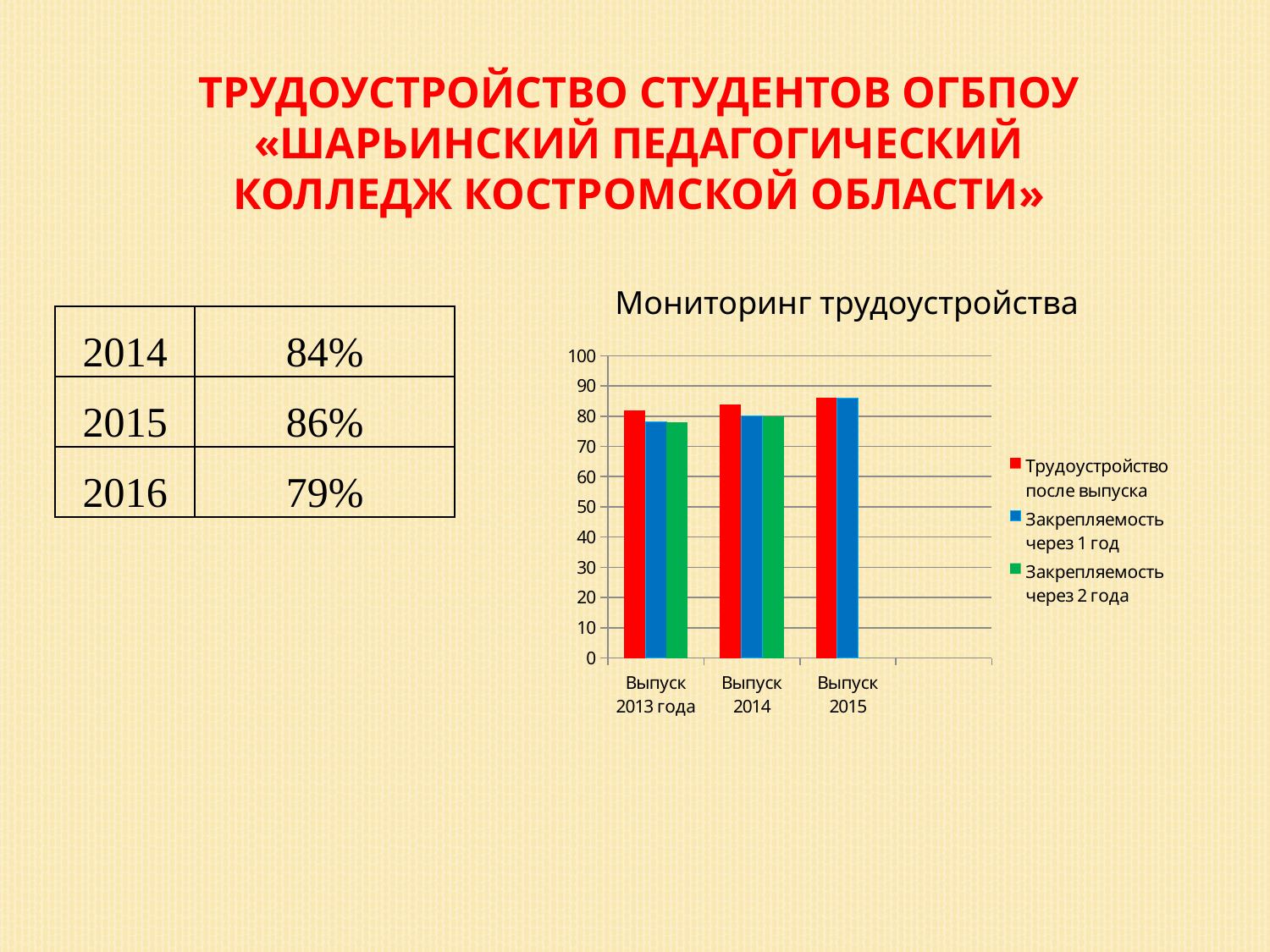
Is the value for Трудоустройство после выпуска for Выпуск 2013 года greater or less than 80? greater Does the value for Трудоустройство после выпуска rise or fall from Выпуск 2013 года to Выпуск 2015? rise Which graduation year has the highest value for Трудоустройство после выпуска? Выпуск 2015 For Выпуск 2013 года, which is larger: Трудоустройство после выпуска or Закрепляемость через 1 год? Трудоустройство после выпуска Is the value for Трудоустройство после выпуска for Выпуск 2015 greater or less than 90? less How many graduation-year categories are shown on the x axis of the chart? 3 Is the value for Трудоустройство после выпуска for Выпуск 2014 greater or less than 80? greater How many series does the chart legend list? 3 What type of chart is shown on the slide? bar chart What colour represents Трудоустройство после выпуска in the chart? red What is the title of the chart? Мониторинг трудоустройства